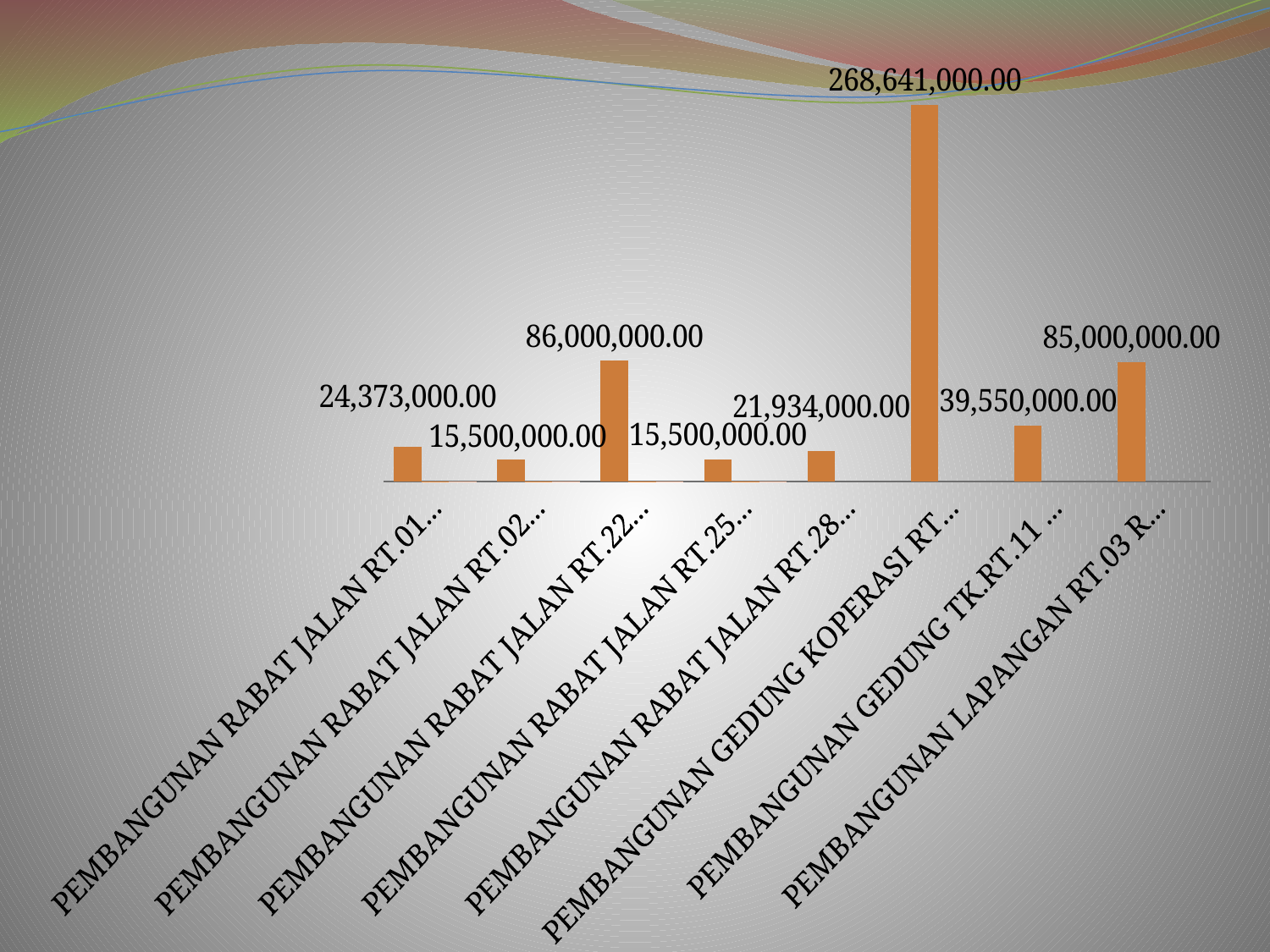
Which is larger, the value for PEMBANGUNAN RABAT JALAN RT.01... or the value for PEMBANGUNAN RABAT JALAN RT.28...? PEMBANGUNAN RABAT JALAN RT.01... What is the value for PEMBANGUNAN GEDUNG TK.RT.11 ...? 39,550,000.00 What is the value for PEMBANGUNAN LAPANGAN RT.03 R...? 85,000,000.00 What is the difference between the values for PEMBANGUNAN GEDUNG KOPERASI RT... and PEMBANGUNAN RABAT JALAN RT.22...? 182,641,000.00 What is the value for PEMBANGUNAN RABAT JALAN RT.01...? 24,373,000.00 What is the lowest value shown in the chart? 15,500,000.00 What kind of chart is shown on the slide? Bar chart Which category has the highest value? PEMBANGUNAN GEDUNG KOPERASI RT... What is the value for PEMBANGUNAN GEDUNG KOPERASI RT...? 268,641,000.00 What is the difference between the values for PEMBANGUNAN GEDUNG TK.RT.11 ... and PEMBANGUNAN RABAT JALAN RT.01...? 15,177,000.00 How many categories are shown in the chart? 8 What is the value for PEMBANGUNAN RABAT JALAN RT.22...? 86,000,000.00